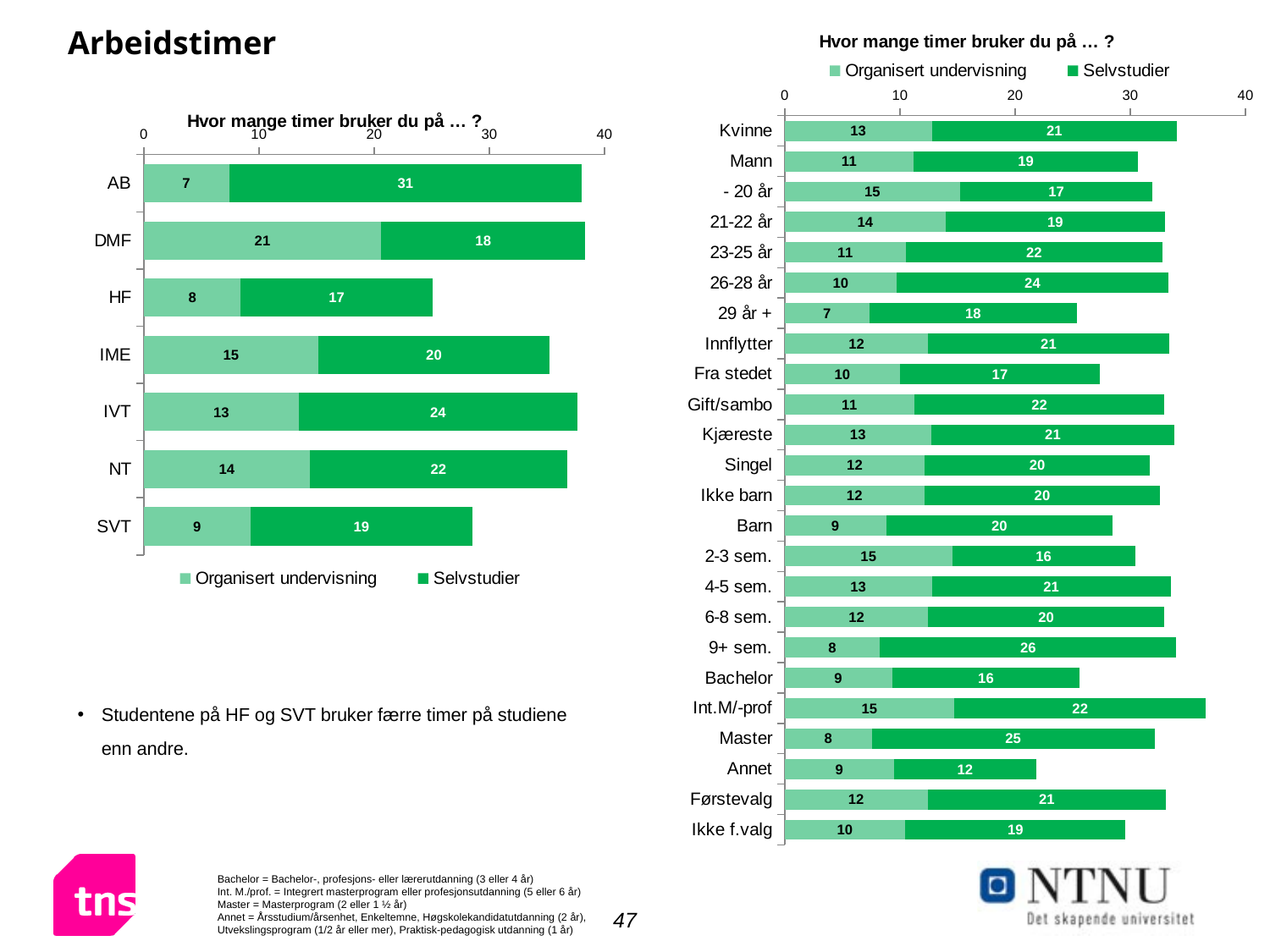
On the right chart, what is the Selvstudier value for 9+ sem.? 26 On the left chart, which category has the lowest Organisert undervisning value? AB On the left chart, what is the difference between the Selvstudier values for IVT and HF? 7 How many series does the legend of the right chart list? 2 On the right chart, which category has the lowest Selvstudier value? Annet On the left chart, what is the total of the stacked bar for HF? 25 On the left chart, what is the Organisert undervisning value for DMF? 21 On the left chart, which category has the highest Selvstudier value? AB On the right chart, what is the total of the stacked bar for Int.M/-prof? 37 How many categories are shown on the left chart? 7 On the right chart, which category has the lowest Organisert undervisning value? 29 år + On the left chart, how many hours of Selvstudier does AB report? 31